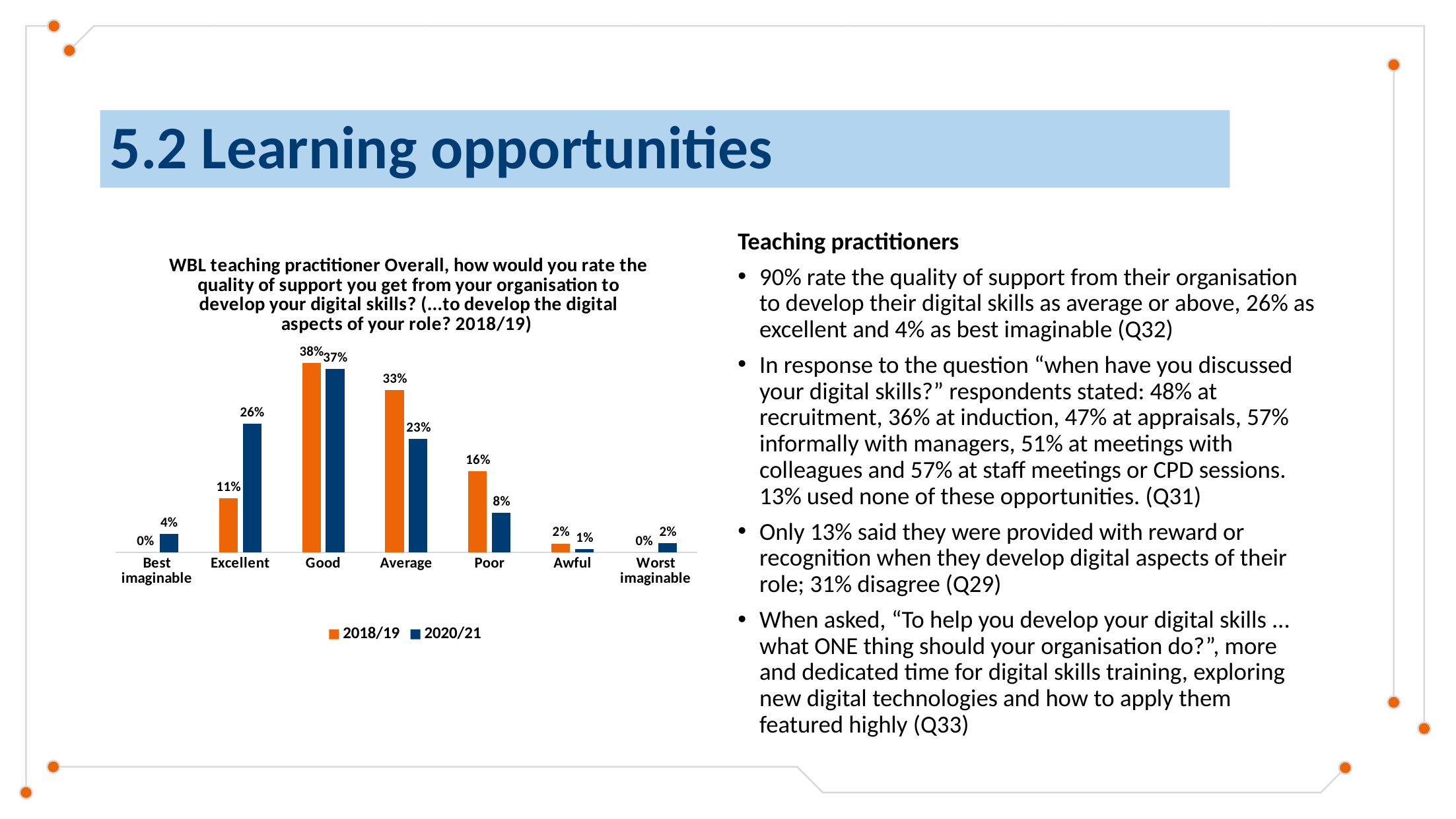
What is the 2018/19 value for Poor? 16% What is the 2018/19 value for Good? 38% What kind of chart is shown on the slide? Bar chart Which category has the highest 2020/21 value? Good How many series does the legend list? 2 What is the difference between the 2020/21 and 2018/19 values for Excellent? 15% How many categories are shown on the x axis? 7 Which is larger for Average: the 2018/19 value or the 2020/21 value? 2018/19 Which category has the highest 2018/19 value? Good What is the difference between the 2018/19 and 2020/21 values for Poor? 8% What is the 2020/21 value for Average? 23% What is the 2020/21 value for Excellent? 26%